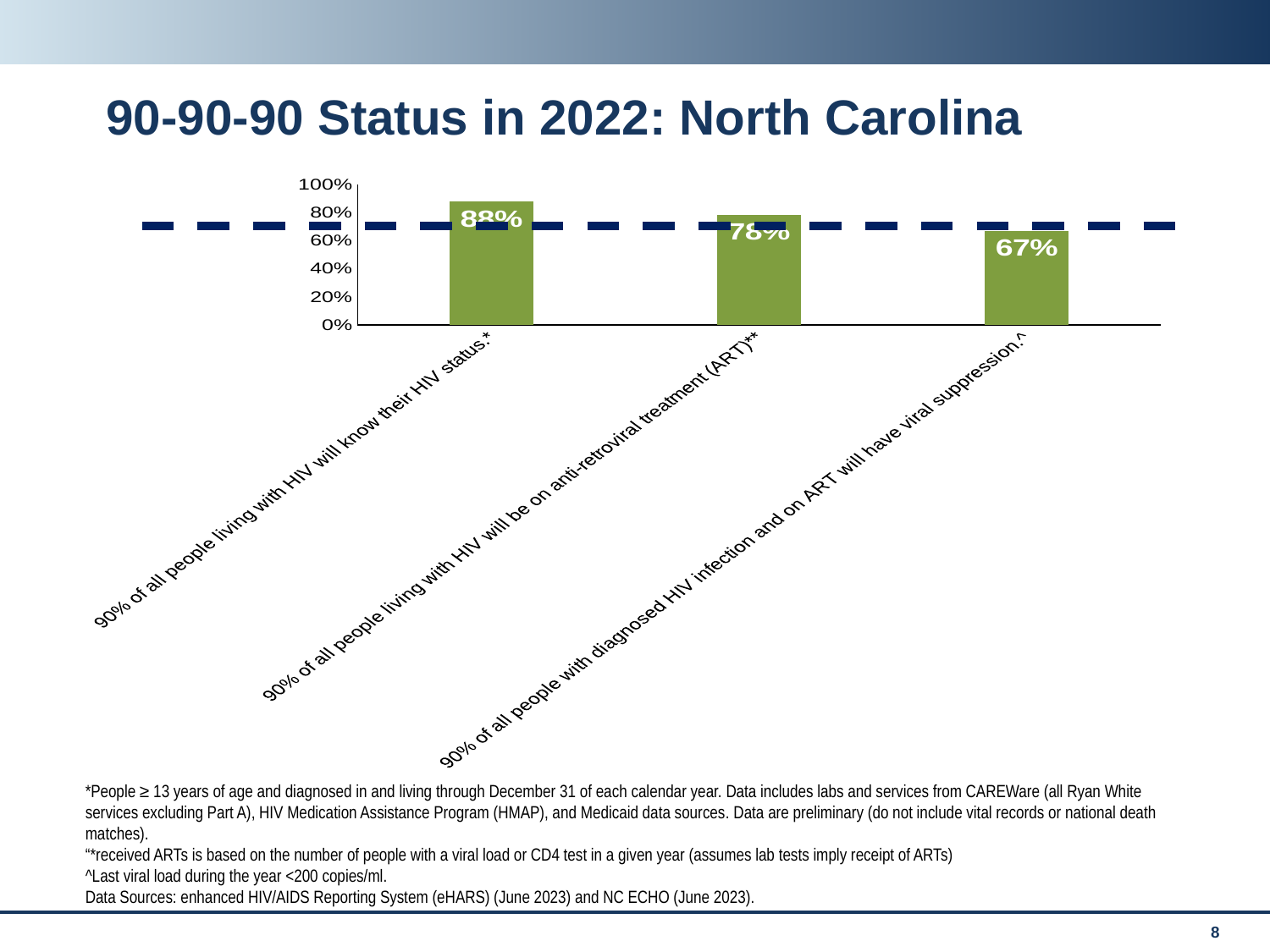
Which category has the highest value? 90% of all people living with HIV will know their HIV status What is the value for the bar labelled '90% of all people with diagnosed HIV infection and on ART will have viral suppression'? 67% What is the value for the bar labelled '90% of all people living with HIV will know their HIV status'? 88% Which is larger: the value for being on anti-retroviral treatment (ART) or the value for viral suppression? Being on anti-retroviral treatment (ART) What is the value for the bar labelled '90% of all people living with HIV will be on anti-retroviral treatment (ART)'? 78% Which category has the lowest value? 90% of all people with diagnosed HIV infection and on ART will have viral suppression How many bars are shown in the chart? 3 Is the value for viral suppression greater or less than 80%? less What kind of chart is shown on the slide? Bar chart What is the difference between the value for knowing HIV status and the value for viral suppression? 21% Do the values rise or fall from left to right across the bars? Fall What is the difference between the value for knowing HIV status and the value for being on anti-retroviral treatment (ART)? 10%